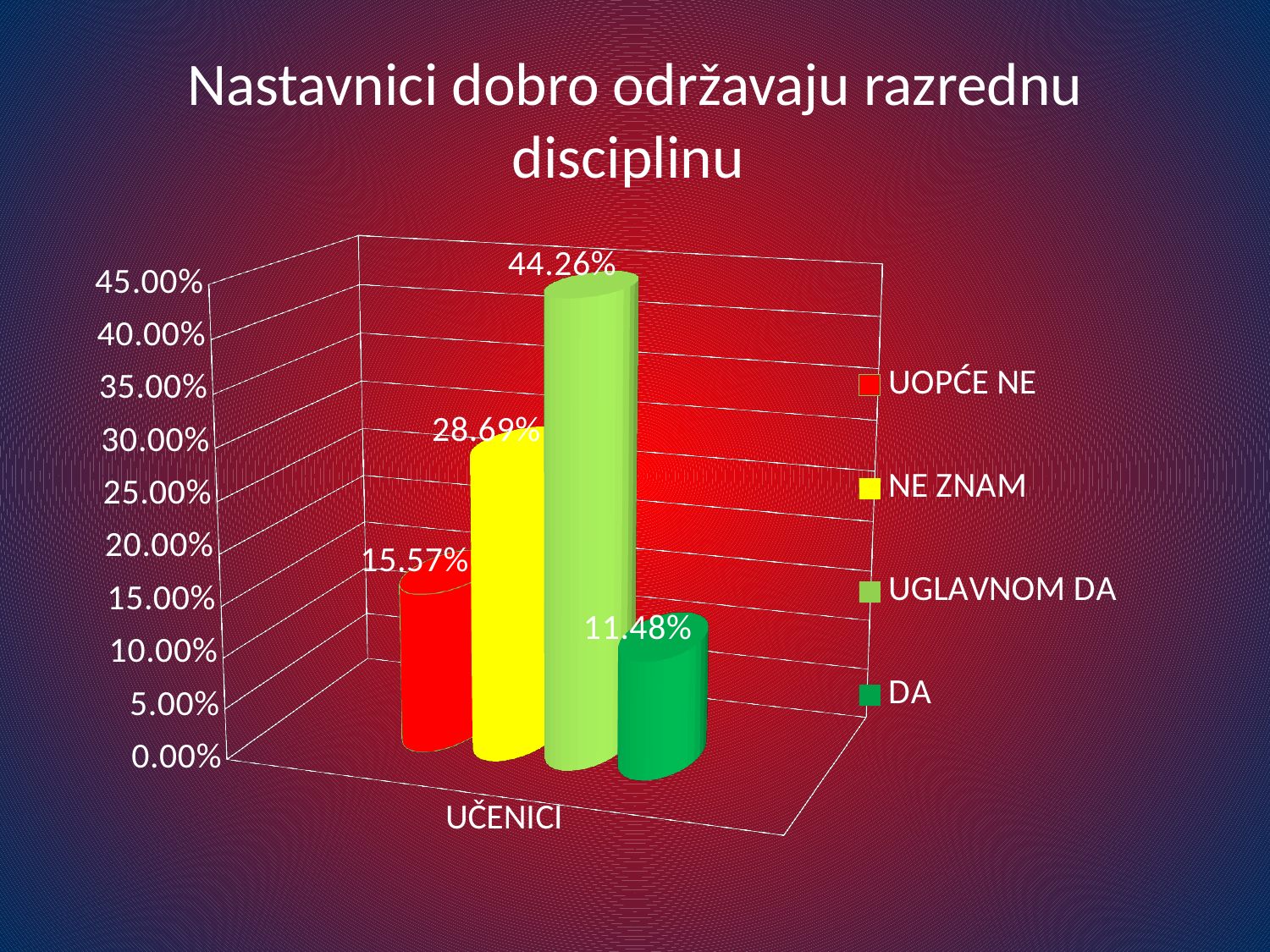
What is the value for UGLAVNOM DA? 44.26% What is the value for DA? 11.48% What kind of chart is shown on the slide? bar chart Which is larger, the value for UOPĆE NE or the value for DA? UOPĆE NE Which response has the lowest value? DA What is the value for NE ZNAM? 28.69% Which response has the highest value? UGLAVNOM DA What is the value for UOPĆE NE? 15.57% What is the difference between the values for UGLAVNOM DA and NE ZNAM? 15.57% What is the title of the chart? Nastavnici dobro održavaju razrednu disciplinu Is the value for NE ZNAM greater or less than 25.00%? greater How many series does the legend list? 4